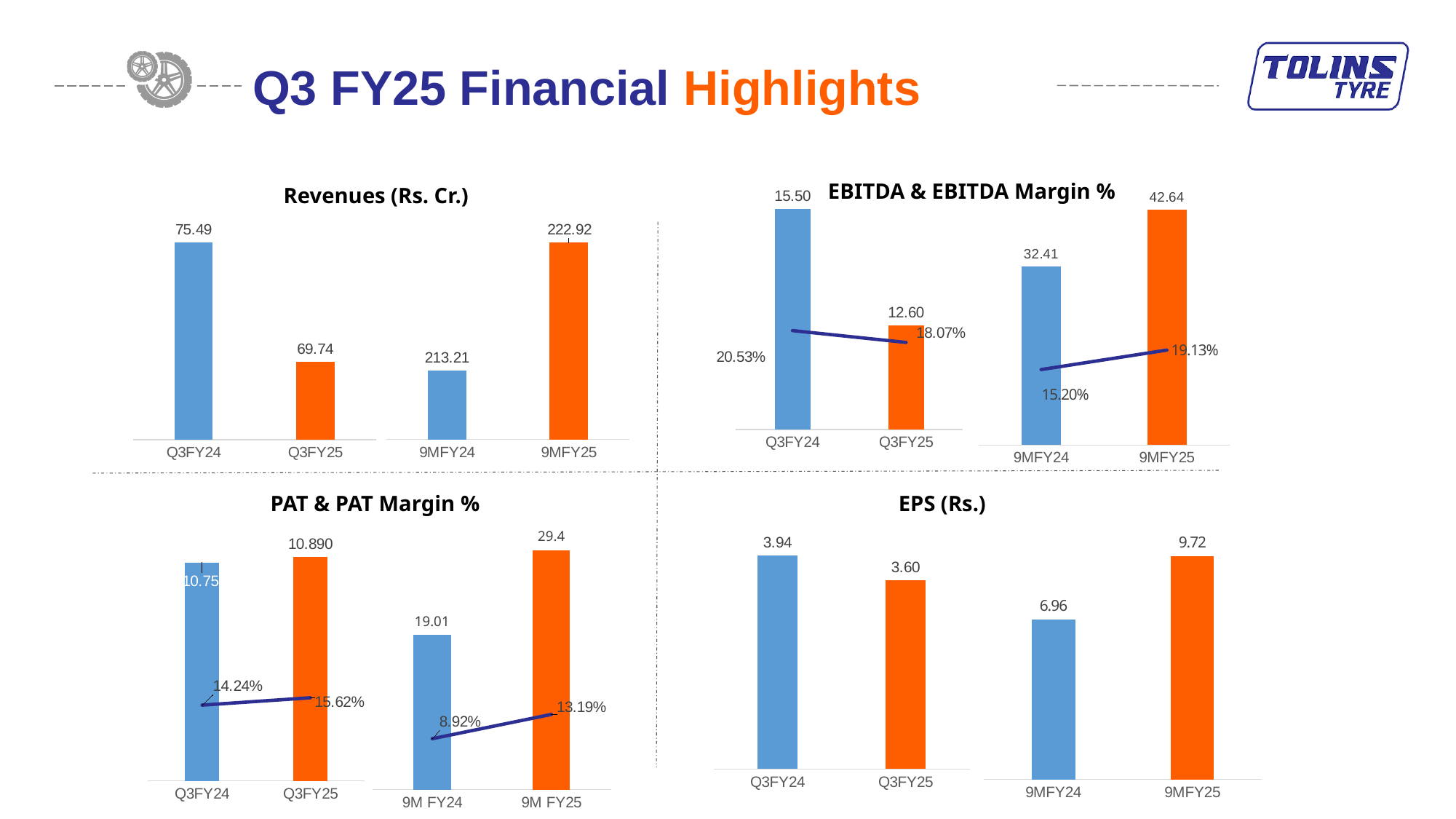
In the Revenues (Rs. Cr.) chart, what is the value for 9MFY25? 222.92 In the EBITDA & EBITDA Margin % chart, what is the EBITDA value for 9MFY25? 42.64 In the EBITDA & EBITDA Margin % chart, which period has the lowest EBITDA value? Q3FY25 What type of chart is the EPS (Rs.) chart? Bar chart In the EPS (Rs.) chart, what is the value for 9MFY25? 9.72 In the PAT & PAT Margin % chart, what is the PAT margin for 9M FY25? 13.19% In the EPS (Rs.) chart, which is larger, the value for Q3FY24 or Q3FY25? Q3FY24 In the PAT & PAT Margin % chart, what is the PAT value for 9M FY24? 19.01 In the EPS (Rs.) chart, what is the difference between the 9MFY25 and 9MFY24 values? 2.76 In the EBITDA & EBITDA Margin % chart, what is the EBITDA margin for Q3FY24? 20.53% In the Revenues (Rs. Cr.) chart, what is the value for Q3FY25? 69.74 In the Revenues (Rs. Cr.) chart, what is the difference between the 9MFY25 and 9MFY24 values? 9.71